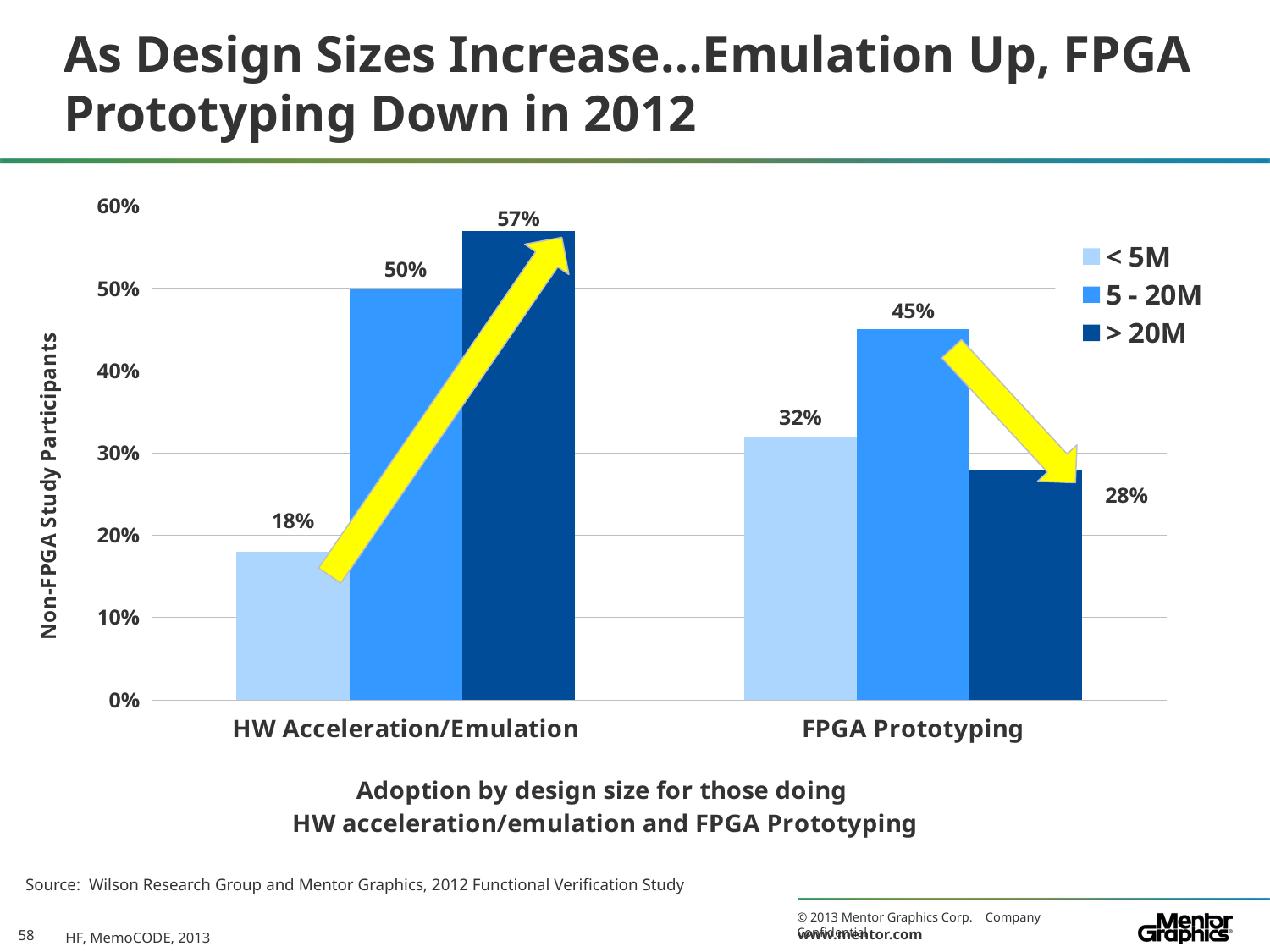
What is the value for the < 5M series in the HW Acceleration/Emulation category? 18% Which design size series has the lowest value in the FPGA Prototyping category? > 20M Which is larger: the < 5M value for HW Acceleration/Emulation or the < 5M value for FPGA Prototyping? FPGA Prototyping What is the difference between the 5 - 20M and > 20M values in the FPGA Prototyping category? 17% What is the label of the y axis? Non-FPGA Study Participants What kind of chart is shown on the slide? Bar chart What is the value for the > 20M series in the FPGA Prototyping category? 28% What is the difference between the > 20M and < 5M values in the HW Acceleration/Emulation category? 39% Which design size series has the highest value in the HW Acceleration/Emulation category? > 20M How many series does the legend list? 3 What is the value for the 5 - 20M series in the FPGA Prototyping category? 45% How many categories are shown on the x axis? 2